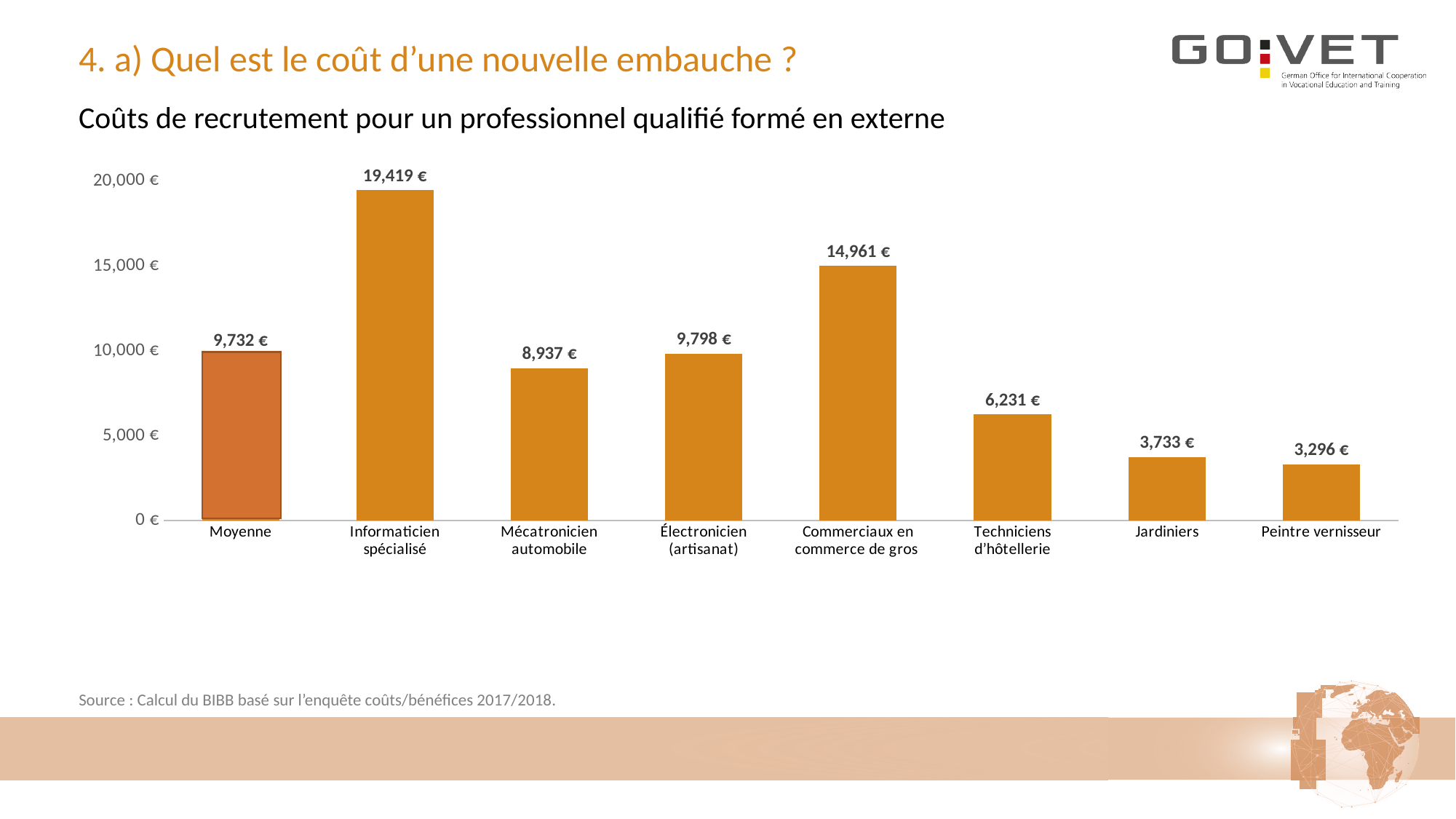
What is the value shown for Moyenne? 9,732 € What is the difference between the value for Jardiniers and Peintre vernisseur? 437 € What is the recruitment cost for Jardiniers? 3,733 € What kind of chart is shown on the slide? bar chart Which is larger, the value for Électronicien (artisanat) or Mécatronicien automobile? Électronicien (artisanat) How many categories are shown on the x axis? 8 What is the recruitment cost for Informaticien spécialisé? 19,419 € Is the value for Commerciaux en commerce de gros greater or less than 10,000 €? greater Which bar is shown in a different colour from the others? Moyenne Which category has the lowest recruitment cost? Peintre vernisseur Which category has the highest recruitment cost? Informaticien spécialisé What is the difference between the recruitment cost for Commerciaux en commerce de gros and Techniciens d'hôtellerie? 8,730 €